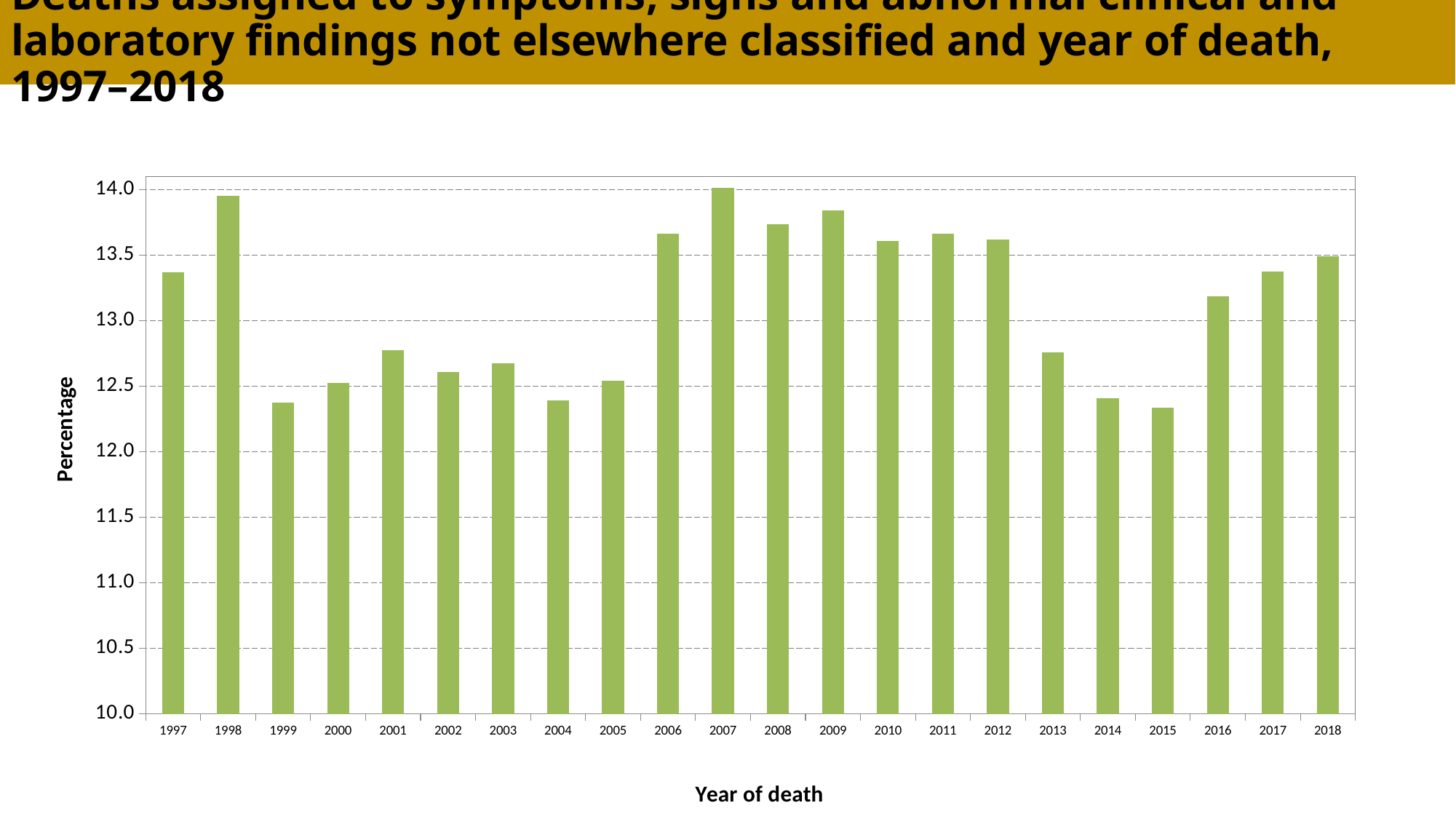
Do the values rise or fall from 2015 to 2018? rise What is the title of the vertical axis of the chart? Percentage What kind of chart is shown on the slide? Bar chart How many years are plotted on the x axis of the chart? 22 Which year has the larger value, 2007 or 2004? 2007 Is the value for 2014 greater or less than 12.5? less Is the value for 2009 greater or less than 13.5? greater Is the value for 1999 greater or less than 12.5? less Do the values rise or fall from 2012 to 2015? fall Which year has the larger value, 1998 or 1999? 1998